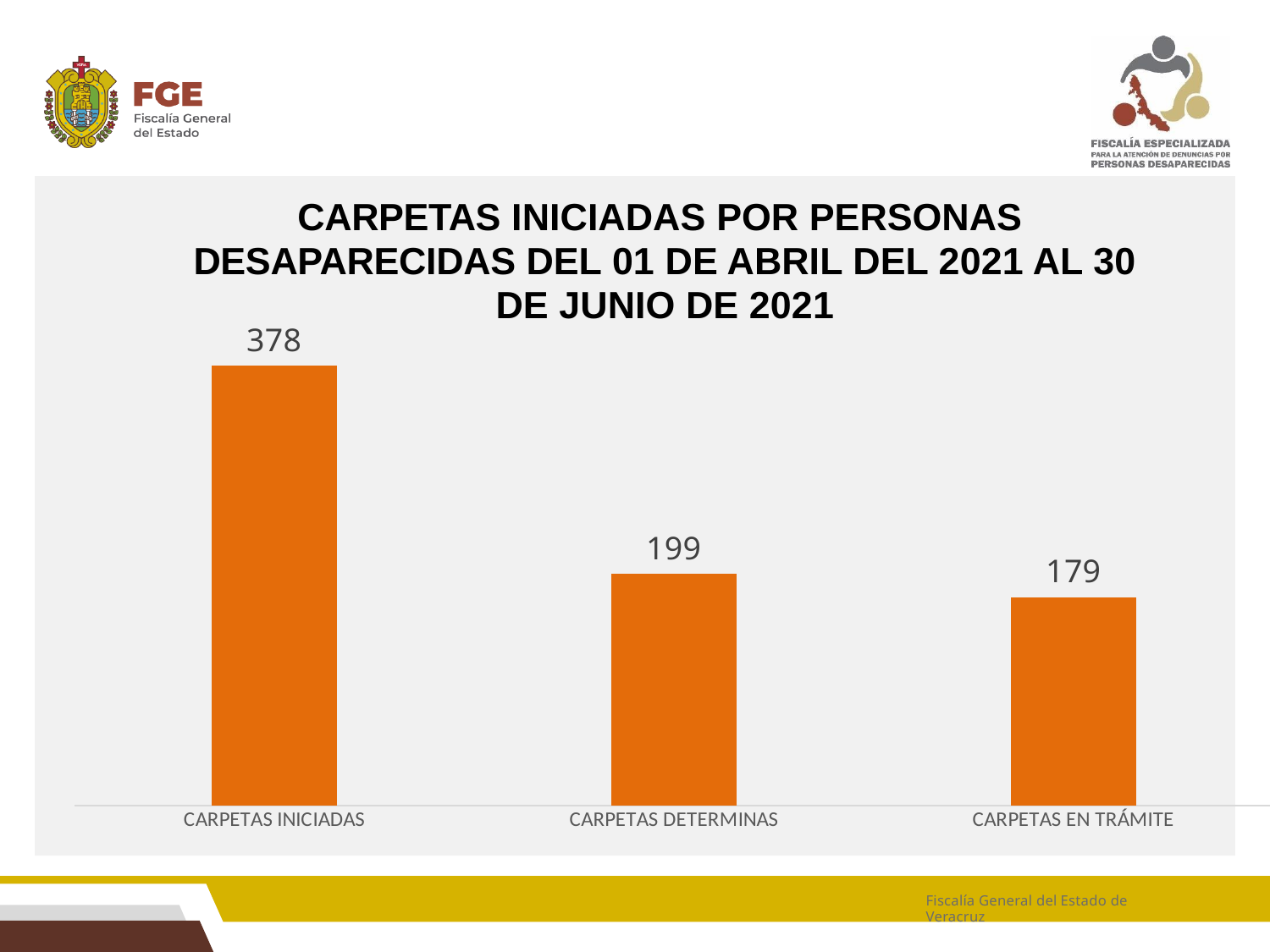
Which category has the highest value? CARPETAS INICIADAS Which is larger, CARPETAS DETERMINAS or CARPETAS EN TRÁMITE? CARPETAS DETERMINAS What is the difference between CARPETAS INICIADAS and CARPETAS DETERMINAS? 179 What is the value for CARPETAS INICIADAS? 378 Which category has the lowest value? CARPETAS EN TRÁMITE What is the title of the chart? CARPETAS INICIADAS POR PERSONAS DESAPARECIDAS DEL 01 DE ABRIL DEL 2021 AL 30 DE JUNIO DE 2021 What kind of chart is shown on the slide? Bar chart How many categories are shown in the chart? 3 What is the difference between CARPETAS DETERMINAS and CARPETAS EN TRÁMITE? 20 Do the values rise or fall from left to right across the categories? Fall What is the value for CARPETAS EN TRÁMITE? 179 What is the value for CARPETAS DETERMINAS? 199